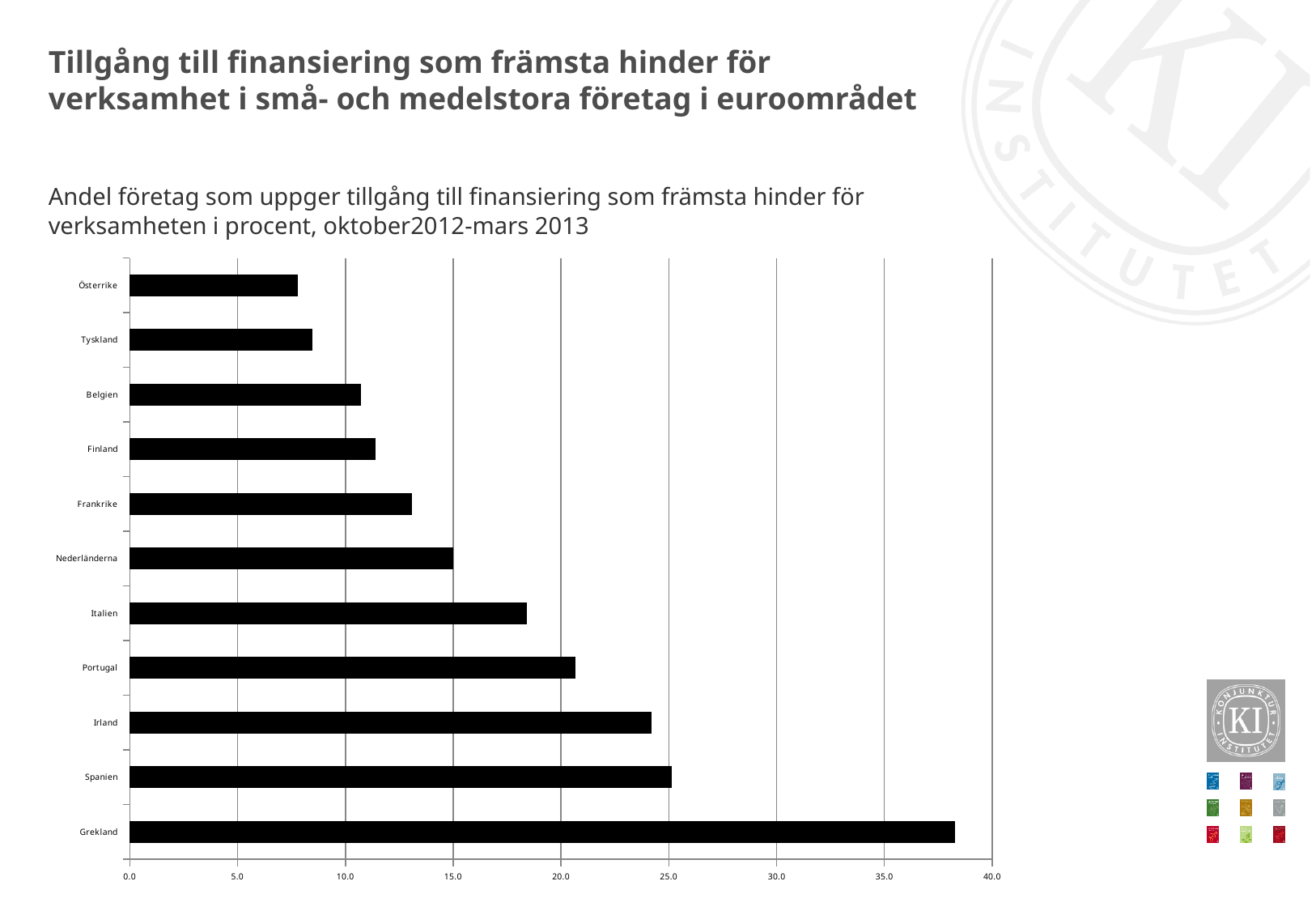
Is the value for Irland greater or less than 25.0? less How many countries are shown in the chart? 11 Which has a larger value, Grekland or Spanien? Grekland Which country has the highest share of firms citing access to financing as the main obstacle? Grekland Is the value for Tyskland greater or less than 10.0? less What is the maximum value shown on the horizontal axis? 40.0 Which country has the lowest value in the chart? Österrike Which has a larger value, Irland or Portugal? Irland Is the value for Grekland greater or less than 35.0? greater What kind of chart is shown on the slide? bar chart